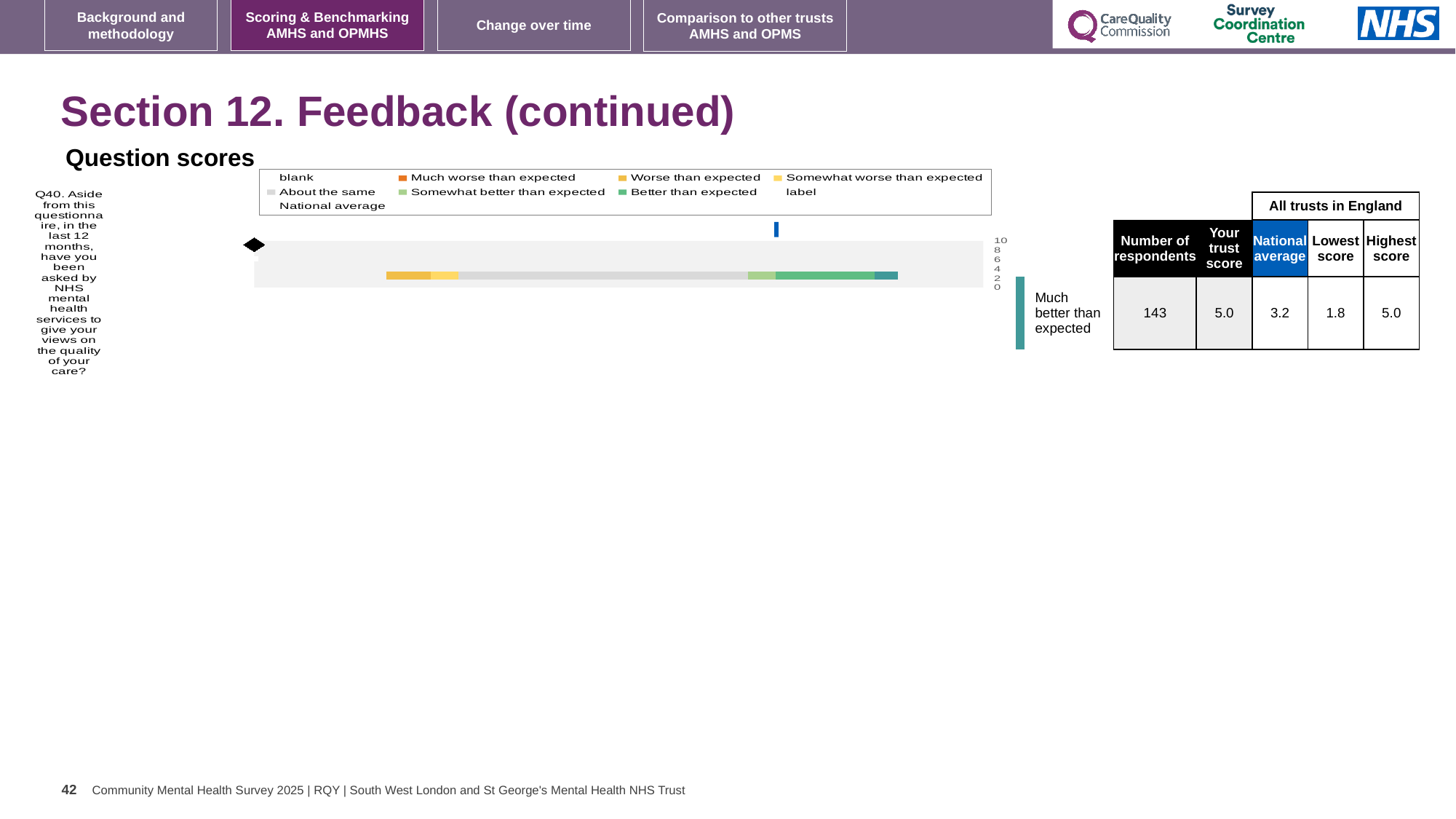
How many questions are plotted in the Question scores chart? 1 Which is larger for Q40: the trust score or the national average? the trust score What is the difference between the trust score and the national average for Q40? 1.8 What is the National average score shown for Q40? 3.2 What is the difference between the highest and lowest scores for Q40? 3.2 How many respondents are shown for Q40? 143 What is the 'Your trust score' value shown for Q40? 5.0 What is the Lowest score among all trusts in England for Q40? 1.8 What colour does the legend use for 'Much worse than expected'? orange What is the Highest score among all trusts in England for Q40? 5.0 What kind of chart is shown under 'Question scores'? bar chart Which benchmark category is Q40 assigned to on this slide? Much better than expected